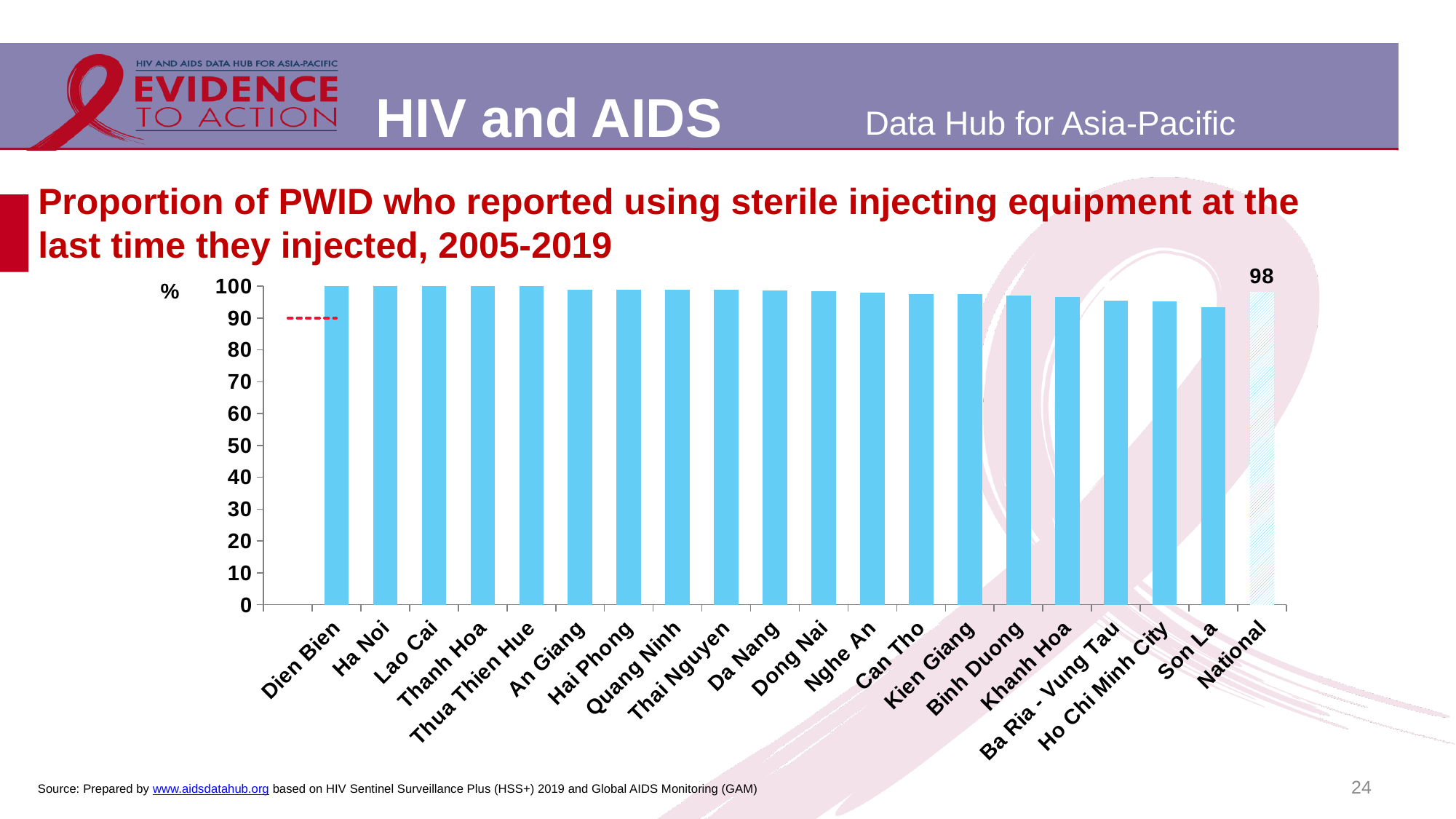
Which is larger, the value for Dien Bien or the value for Son La? Dien Bien What is the title of the chart? Proportion of PWID who reported using sterile injecting equipment at the last time they injected, 2005-2019 How many categories are shown on the x axis of the chart? 20 What kind of chart is shown on the slide? bar chart What is the value shown for National? 98 Is the value for Son La greater or less than 90? greater What unit label is shown on the y axis of the chart? % Do the bar values rise or fall moving from left to right along the x axis? fall Which is larger, the value for Ha Noi or the value for Ba Ria - Vung Tau? Ha Noi Is the value for Dien Bien greater or less than 90? greater Is the value for Ho Chi Minh City greater or less than 90? greater Which province has the lowest bar in the chart? Son La